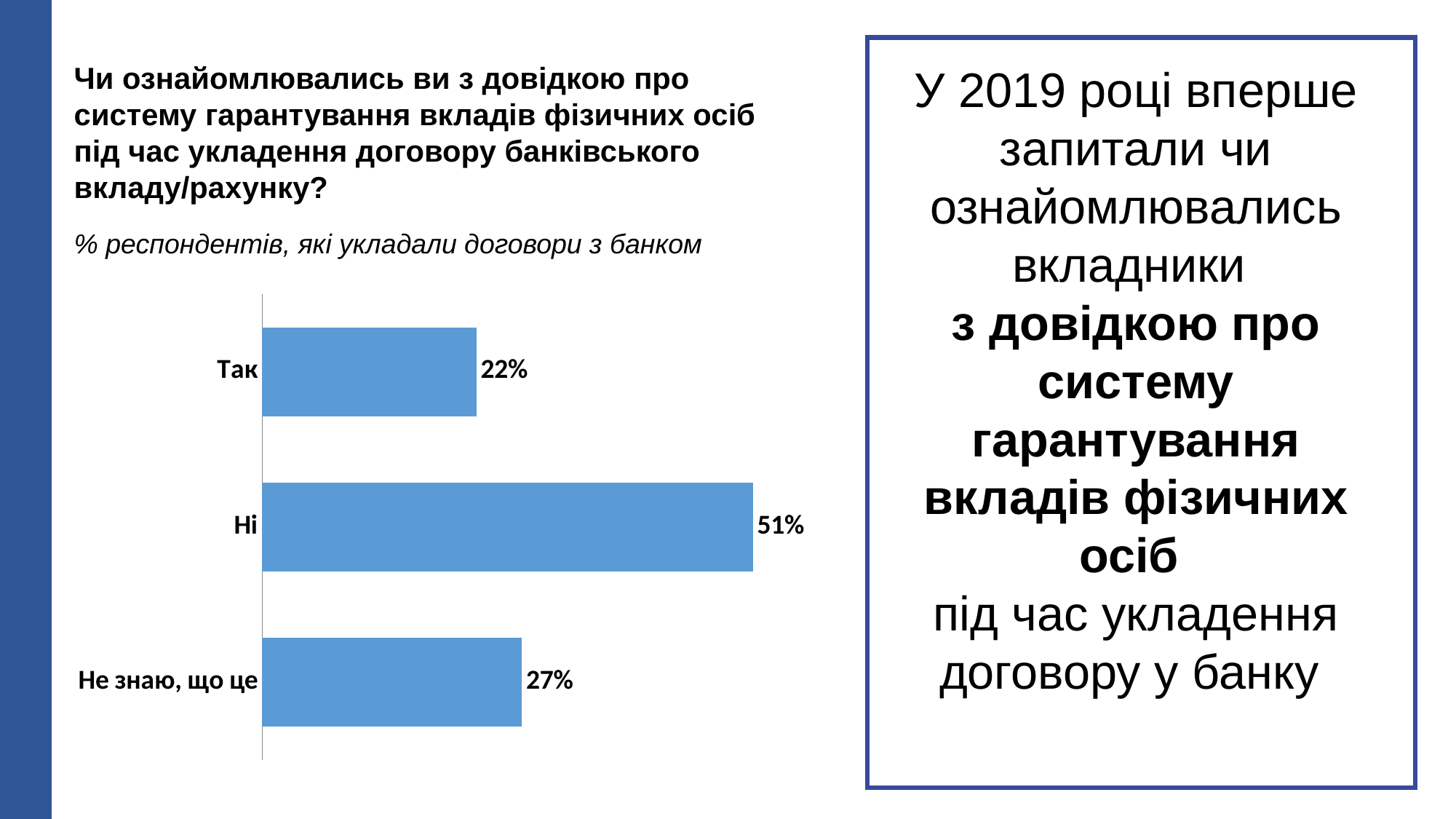
What colour are the bars in the chart? blue What is the value for "Так"? 22% What kind of chart is shown on the slide? bar chart Which is larger, the value for "Не знаю, що це" or the value for "Так"? Не знаю, що це Which category has the lowest value? Так Which category has the highest value? Ні What is the value for "Не знаю, що це"? 27% What is the difference between the values for "Не знаю, що це" and "Так"? 5% What is the difference between the values for "Ні" and "Так"? 29% How many categories are shown in the chart? 3 What is the total of the three values shown in the chart? 100% What is the value for "Ні"? 51%